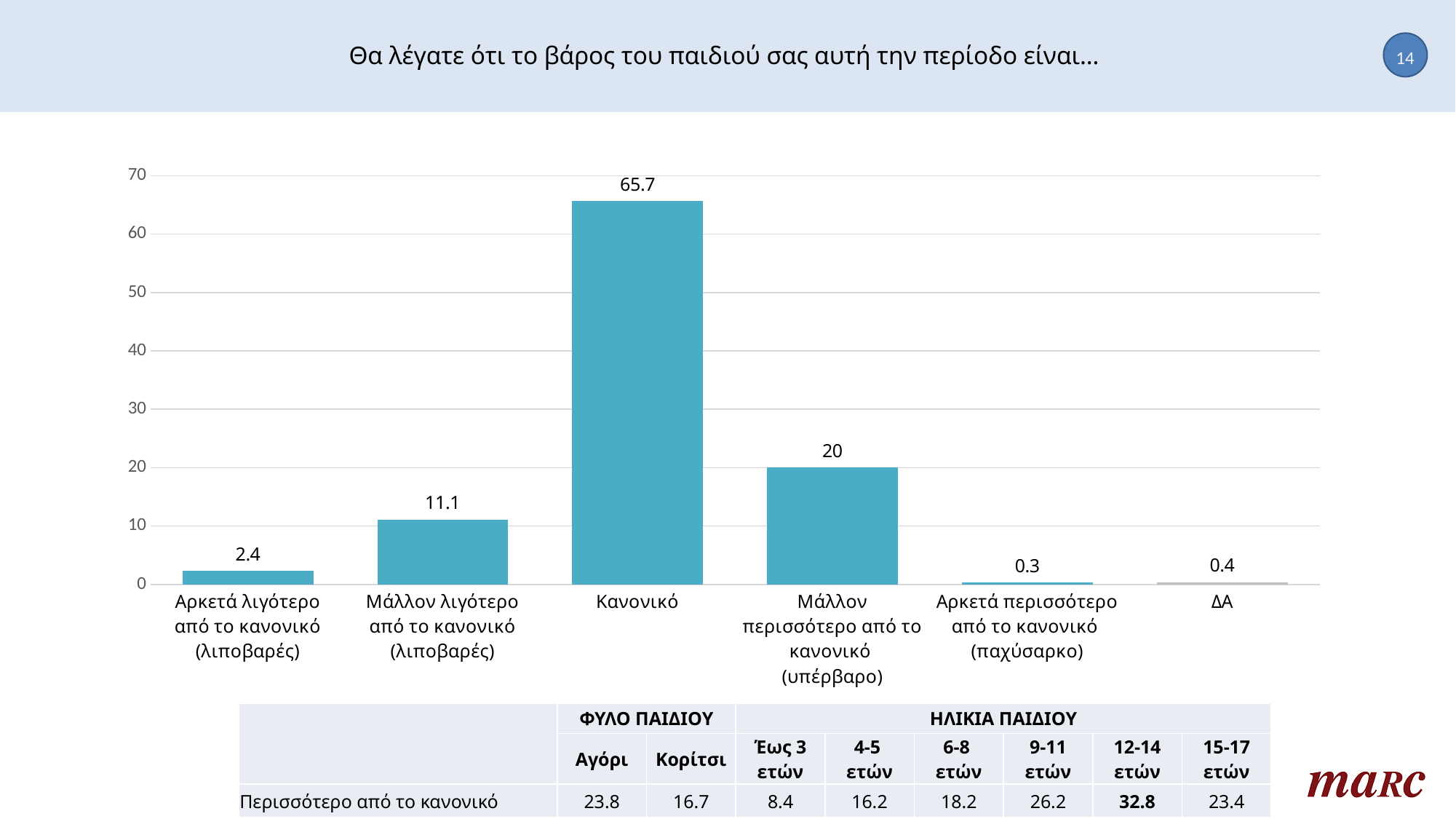
What is the value for Μάλλον λιγότερο από το κανονικό (λιποβαρές)? 11.1 How many categories are shown in the chart? 6 Which is larger, the value for Μάλλον λιγότερο από το κανονικό (λιποβαρές) or the value for Αρκετά λιγότερο από το κανονικό (λιποβαρές)? Μάλλον λιγότερο από το κανονικό (λιποβαρές) What is the title of the chart? Θα λέγατε ότι το βάρος του παιδιού σας αυτή την περίοδο είναι... What is the value for ΔΑ? 0.4 Is the value for Κανονικό greater or less than 60? greater What kind of chart is shown on the slide? bar chart Which category has the highest value? Κανονικό What is the value for Κανονικό? 65.7 What is the difference between the values for Κανονικό and Μάλλον περισσότερο από το κανονικό (υπέρβαρο)? 45.7 What is the value for Μάλλον περισσότερο από το κανονικό (υπέρβαρο)? 20 Which category has the lowest value? Αρκετά περισσότερο από το κανονικό (παχύσαρκο)